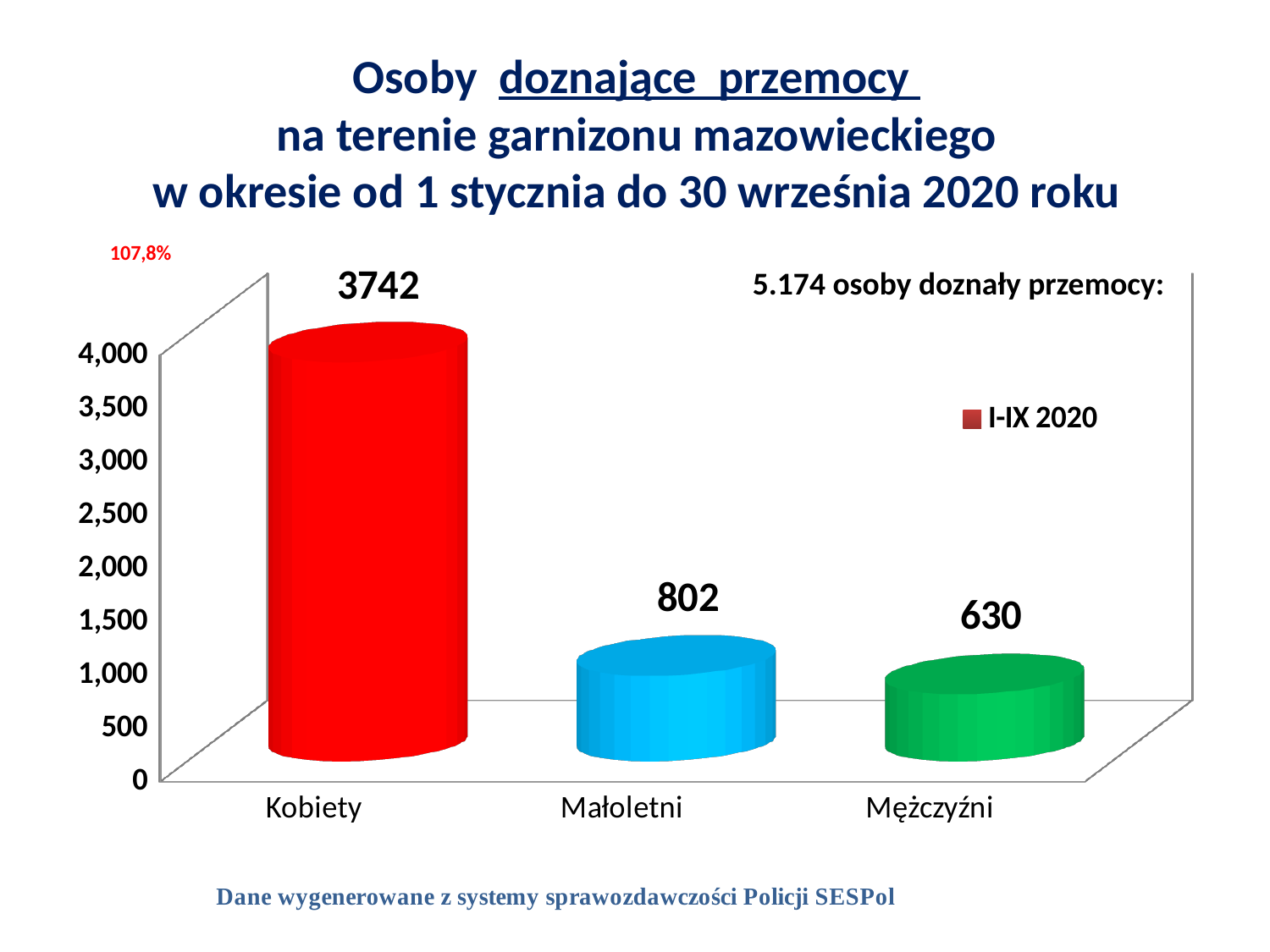
What is the difference between the values for Małoletni and Mężczyźni? 172 Which category has the highest value? Kobiety What is the difference between the values for Kobiety and Małoletni? 2940 How many categories are shown on the x axis? 3 What is the value for Mężczyźni? 630 What is the value for Małoletni? 802 Which is larger, the value for Małoletni or the value for Mężczyźni? Małoletni Which category has the lowest value? Mężczyźni What series name does the legend show? I-IX 2020 What is the value for Kobiety? 3742 How many series does the legend list? 1 What kind of chart is shown on the slide? bar chart